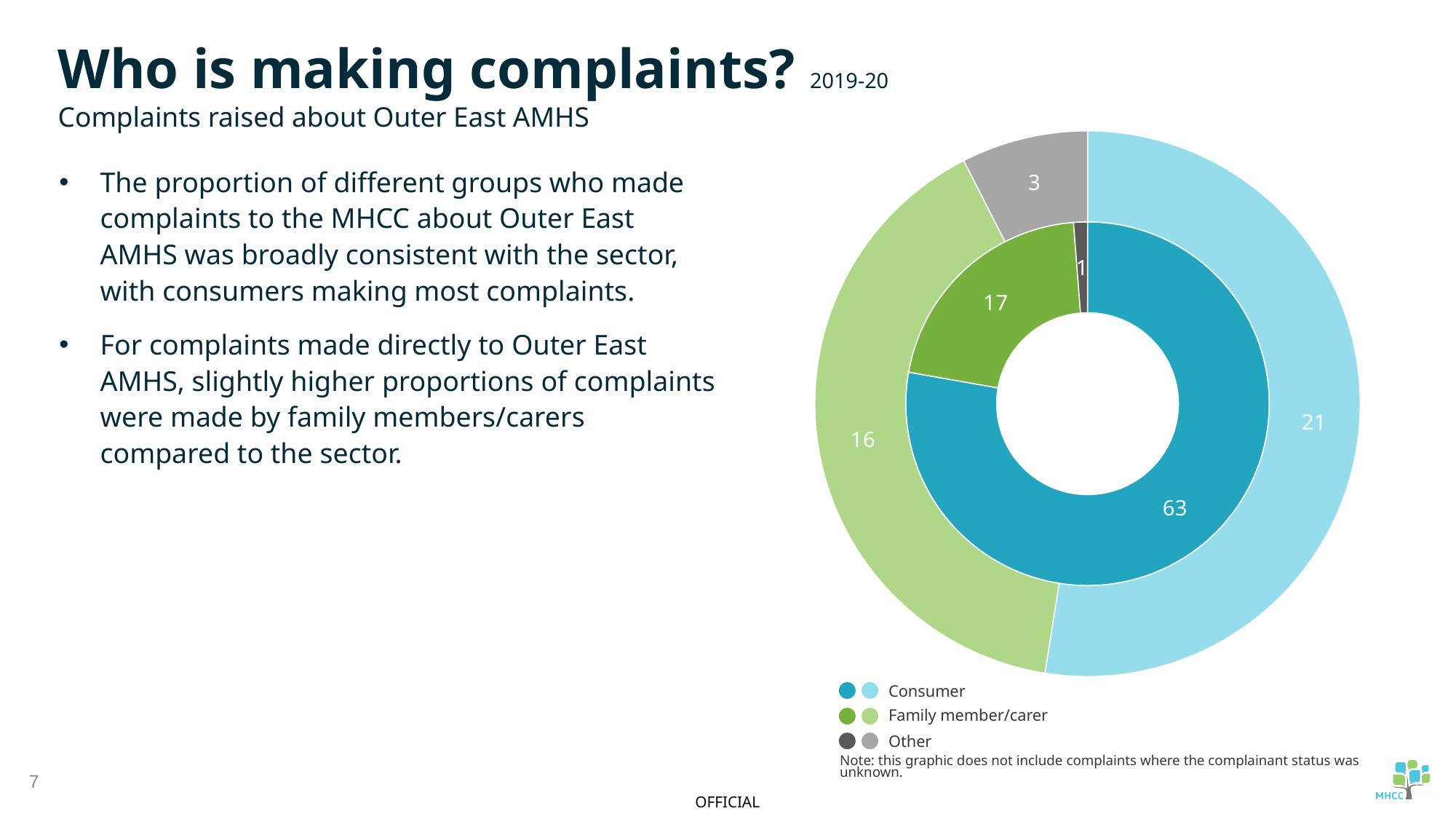
Which category has the largest value in the inner ring of the doughnut chart? Consumer In the outer ring of the doughnut chart, what is the value for Consumer? 21 In the inner ring of the doughnut chart, what is the value for Consumer? 63 In the inner ring of the doughnut chart, what is the value for Other? 1 In the inner ring of the doughnut chart, what is the difference between the Consumer value and the Family member/carer value? 46 What kind of chart is shown on the slide? Doughnut chart In the outer ring of the doughnut chart, what is the value for Other? 3 How many categories does the legend of the doughnut chart list? 3 In the outer ring of the doughnut chart, what is the value for Family member/carer? 16 In the inner ring of the doughnut chart, what is the value for Family member/carer? 17 Which category has the smallest value in the outer ring of the doughnut chart? Other What is the total of the three values in the outer ring of the doughnut chart? 40